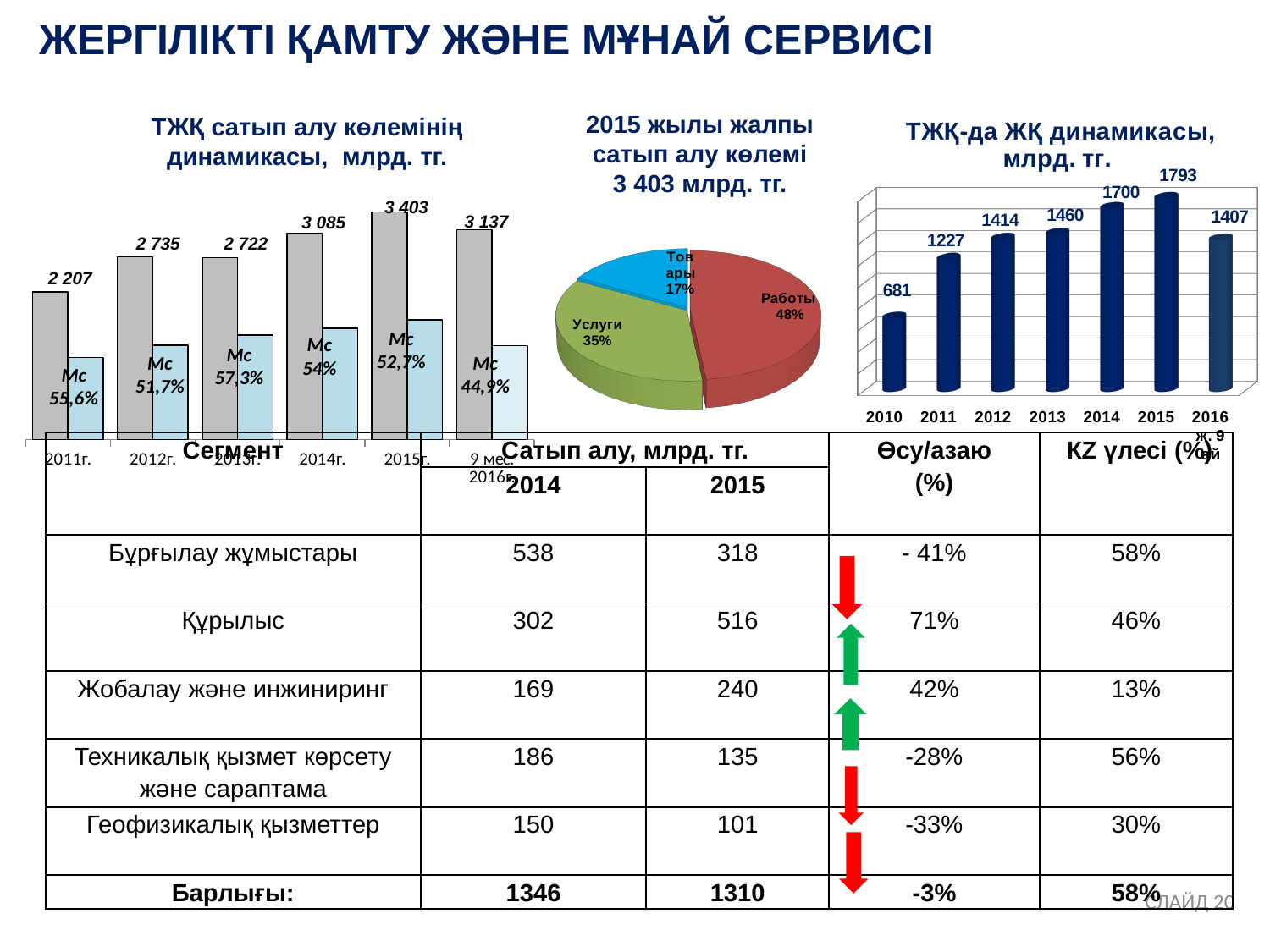
In the chart 'ТЖҚ-да ЖҚ динамикасы, млрд. тг.', what is the value for 2015? 1793 In the chart 'ТЖҚ-да ЖҚ динамикасы, млрд. тг.', which year has the lowest value? 2010 In the chart 'ТЖҚ-да ЖҚ динамикасы, млрд. тг.', what is the value for 2010? 681 In the chart 'ТЖҚ-да ЖҚ динамикасы, млрд. тг.', which year has the highest value? 2015 In the chart 'ТЖҚ-да ЖҚ динамикасы, млрд. тг.', how many years are shown? 7 What kind of chart is the middle chart titled '2015 жылы жалпы сатып алу көлемі 3 403 млрд. тг.'? Pie chart In the pie chart '2015 жылы жалпы сатып алу көлемі 3 403 млрд. тг.', which slice is the smallest? Товары In the chart 'ТЖҚ сатып алу көлемінің динамикасы, млрд. тг.', what is the value of the tall bar for 2015г.? 3 403 In the chart 'ТЖҚ сатып алу көлемінің динамикасы, млрд. тг.', which is larger: the value for 2012г. or for 2013г.? 2012г. In the pie chart '2015 жылы жалпы сатып алу көлемі 3 403 млрд. тг.', what share does 'Работы' have? 48% In the chart 'ТЖҚ-да ЖҚ динамикасы, млрд. тг.', what is the difference between the values for 2015 and 2014? 93 In the chart 'ТЖҚ сатып алу көлемінің динамикасы, млрд. тг.', what is the Мс percentage shown for 2013г.? 57,3%